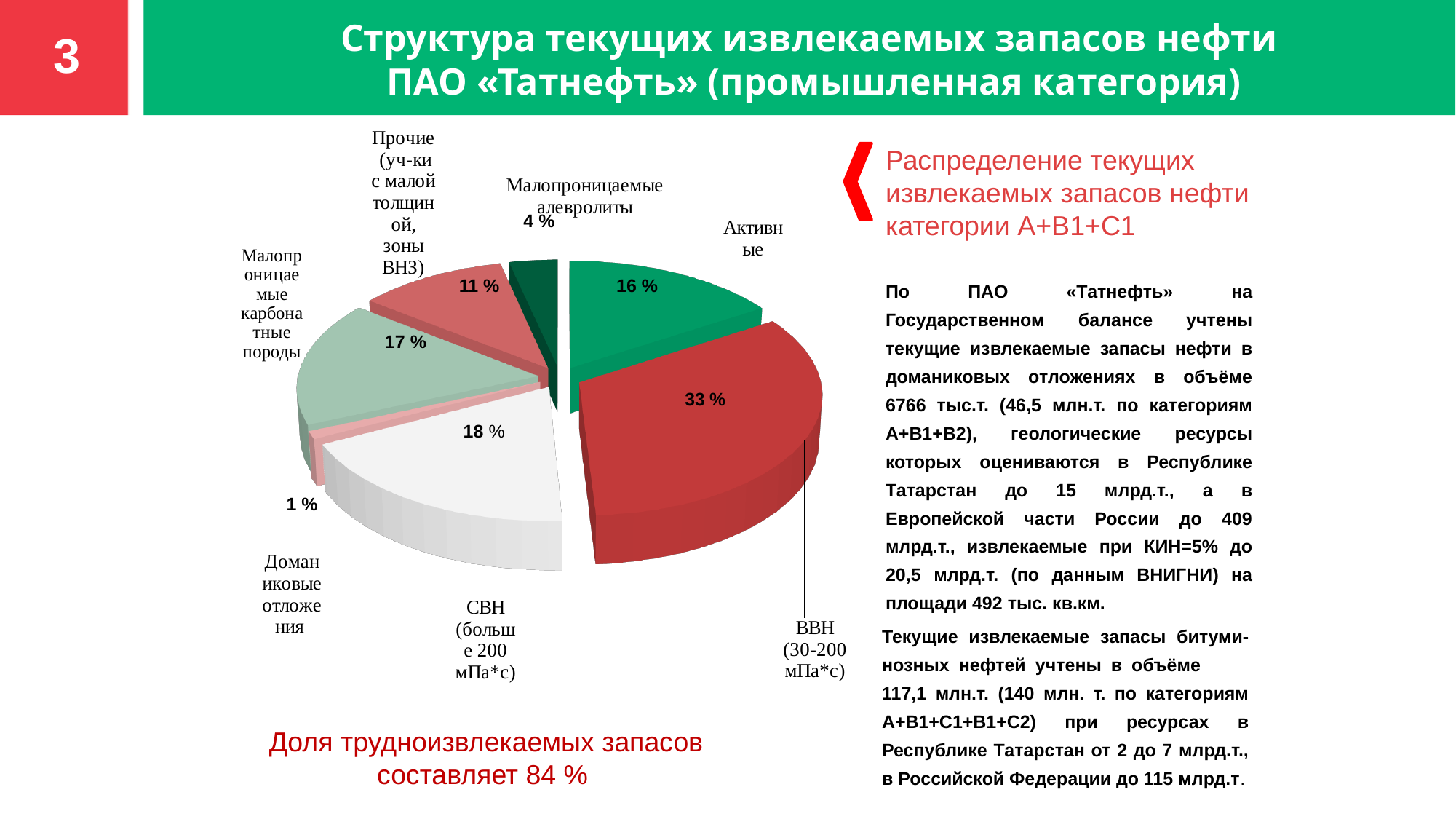
Which slice of the pie is the smallest? Доманиковые отложения Which slice of the pie is the largest? ВВН (30-200 мПа*с) How many slices does the pie chart have? 7 What share is shown for Малопроницаемые карбонатные породы? 17 % What percentage is shown for СВН (больше 200 мПа*с)? 18 % Which is larger: Малопроницаемые алевролиты or Прочие (уч-ки с малой толщиной, зоны ВНЗ)? Прочие (уч-ки с малой толщиной, зоны ВНЗ) What type of chart is shown on the slide? Pie chart What percentage is labelled for Прочие (уч-ки с малой толщиной, зоны ВНЗ)? 11 % What is the value for Доманиковые отложения? 1 % What share of the pie does the ВВН (30-200 мПа*с) slice have? 33 % What is the value shown for the Активные slice? 16 % What is the difference between the ВВН (30-200 мПа*с) slice and the Активные slice? 17 %